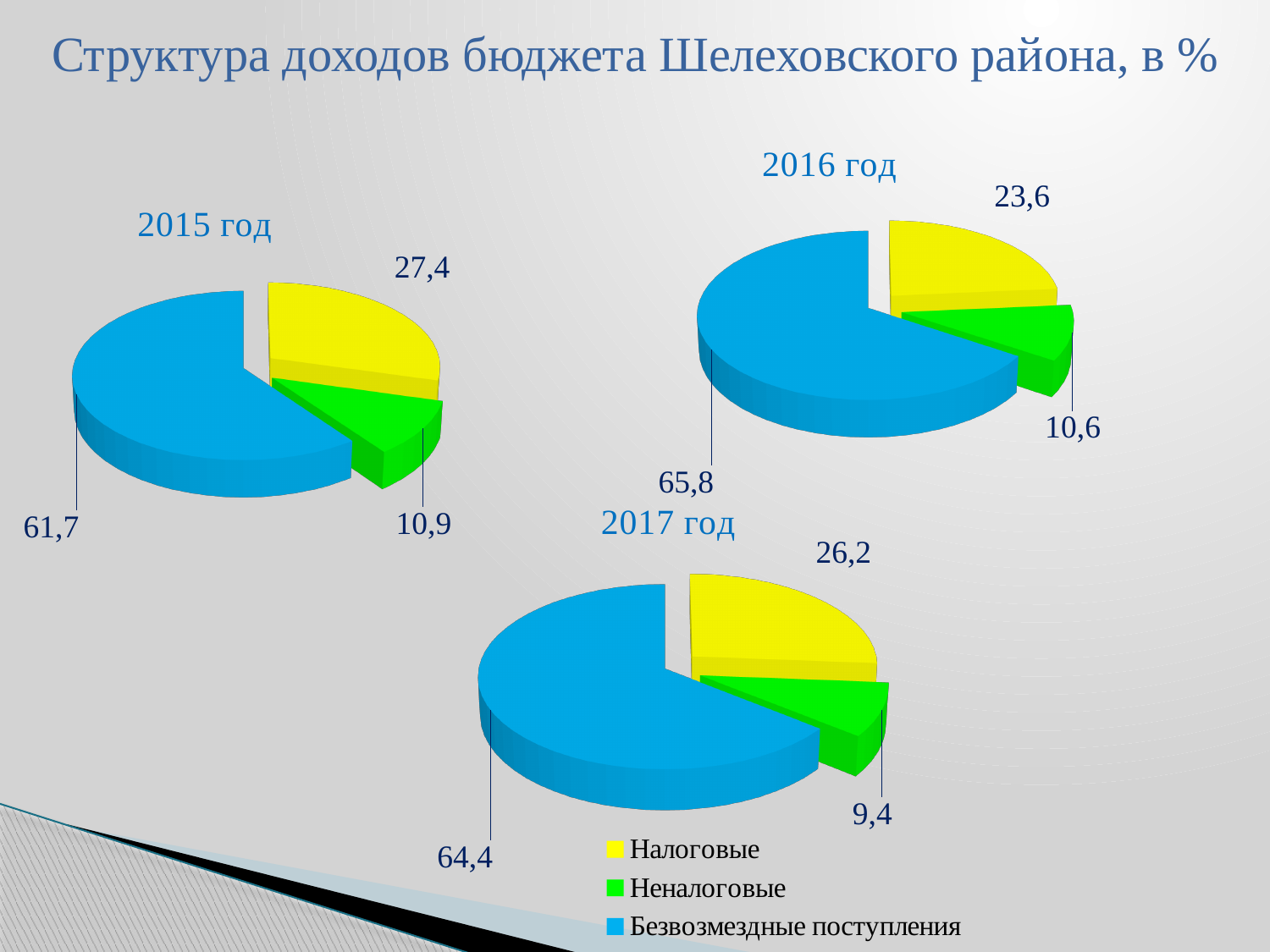
In the 2016 год chart, what is the value for Безвозмездные поступления? 65,8 Which colour represents Неналоговые in the legend? Green In the 2017 год chart, what is the difference between Безвозмездные поступления and Налоговые? 38,2 In the 2015 год chart, which category has the smallest slice? Неналоговые In the 2017 год chart, what is the value for Неналоговые? 9,4 How many entries does the legend list? 3 What kind of chart is used for 2016 год? Pie chart In the 2016 год chart, which category has the largest slice? Безвозмездные поступления Which is larger: Налоговые in the 2015 год chart or Налоговые in the 2016 год chart? 2015 год How many slices does the 2017 год pie chart have? 3 In the 2015 год chart, what is the value for Налоговые? 27,4 How many pie charts are on the slide? 3